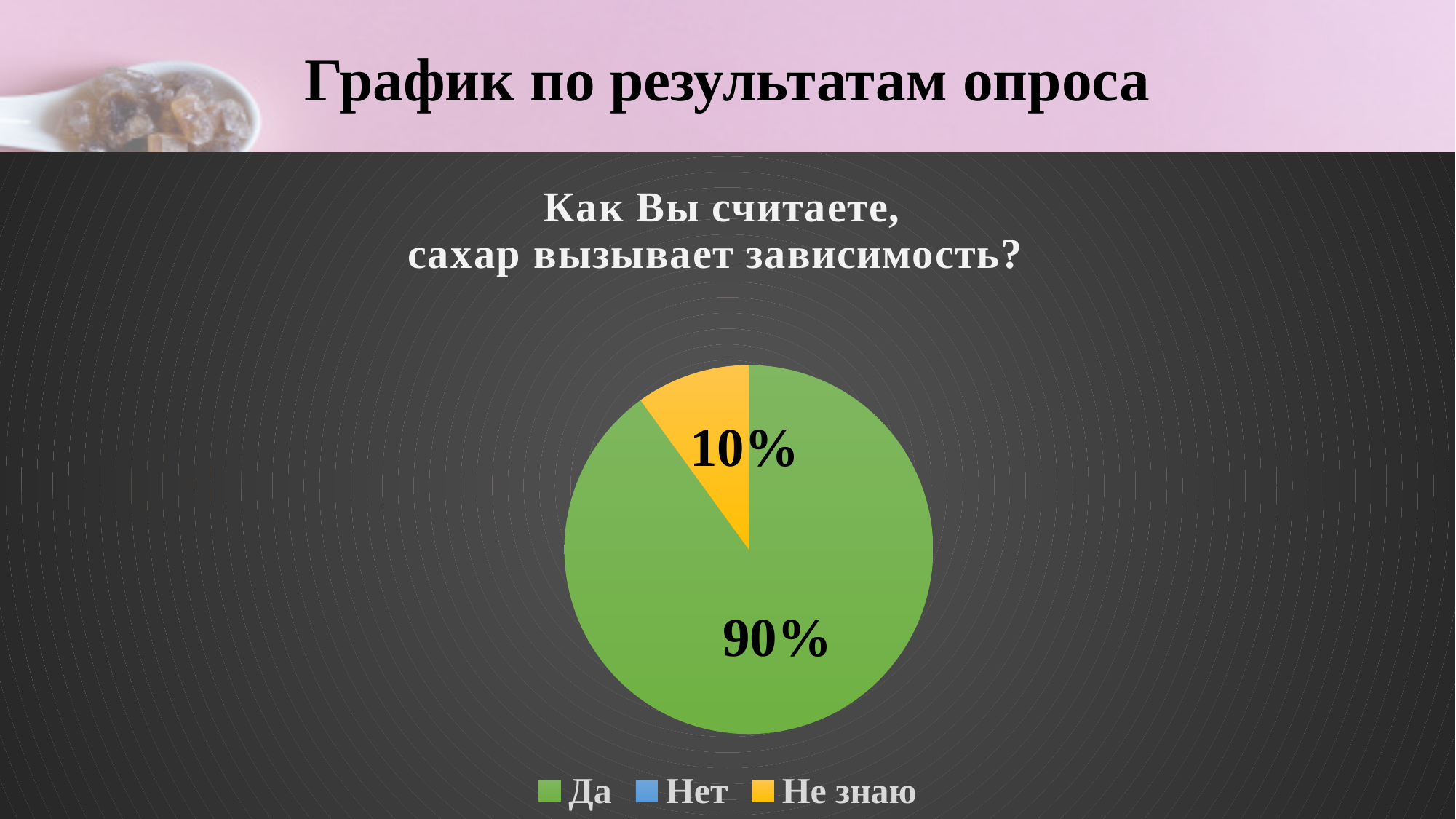
What is the title of the chart? Как Вы считаете, сахар вызывает зависимость? Is the share for "Не знаю" greater or less than 50%? less Which answer has the largest slice of the pie? Да Which of the two visible slices is larger, "Да" or "Не знаю"? Да What share of respondents answered "Да"? 90% What colour represents the "Не знаю" answer? yellow What kind of chart is shown on the slide? pie chart What share of respondents answered "Не знаю"? 10% How many slices are visible in the pie? 2 What is the difference in percentage points between the "Да" and "Не знаю" slices? 80 How many entries does the legend list? 3